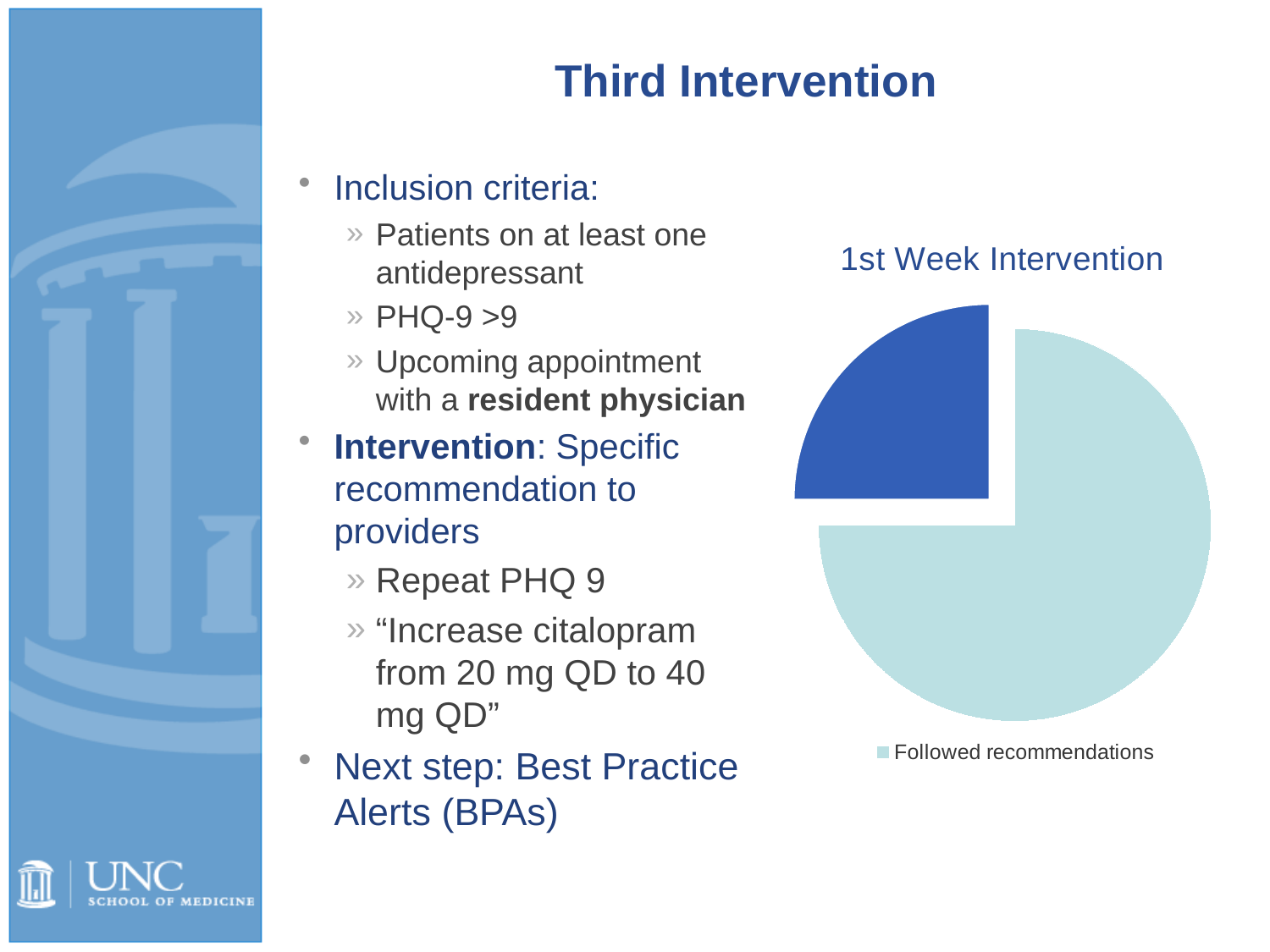
Which slice of the pie chart is larger: the light blue 'Followed recommendations' slice or the dark blue slice? Followed recommendations What kind of chart is shown on the slide? pie chart Which category takes up the largest share of the pie chart? Followed recommendations How many slices does the pie chart have? 2 How many entries does the chart's legend list? 1 What is the title of the chart on the slide? 1st Week Intervention Which slice of the pie chart is the smallest? the dark blue slice What is the legend entry shown below the pie chart? Followed recommendations